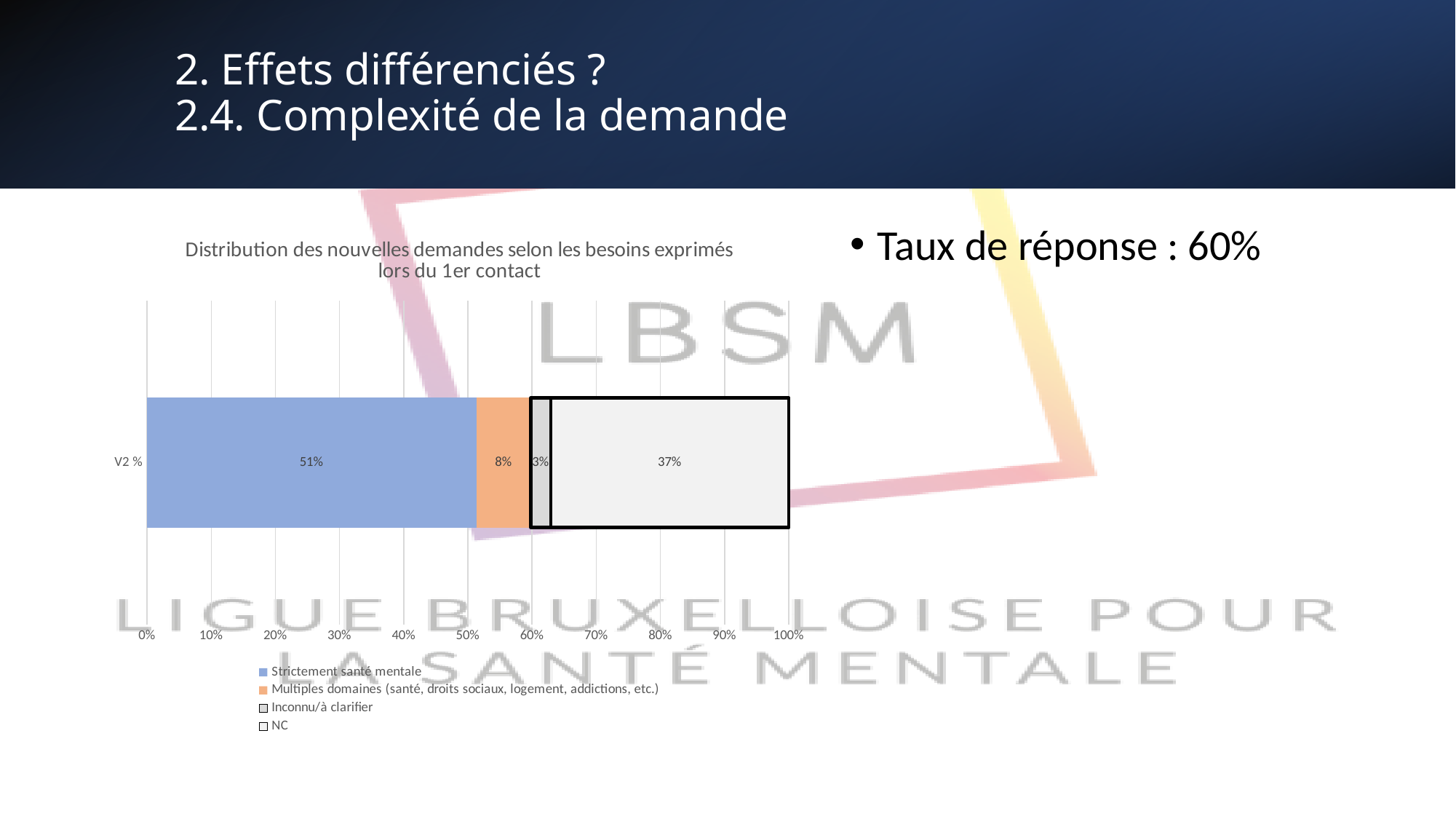
What is the title of the chart? Distribution des nouvelles demandes selon les besoins exprimés lors du 1er contact What kind of chart is shown on the slide? Stacked bar chart Which is larger, the 'Multiples domaines' value or the 'NC' value? NC Which series has the largest share of the V2 % bar? Strictement santé mentale What is the value for 'Strictement santé mentale' in the V2 % bar? 51% What is the difference between the 'Strictement santé mentale' and 'NC' values? 14% How many series does the legend list? 4 What is the total of the V2 % stacked bar? 99% Which series has the smallest share of the V2 % bar? Inconnu/à clarifier What is the value for 'Multiples domaines (santé, droits sociaux, logement, addictions, etc.)' in the V2 % bar? 8% What is the value for 'NC' in the V2 % bar? 37% What is the value for 'Inconnu/à clarifier' in the V2 % bar? 3%